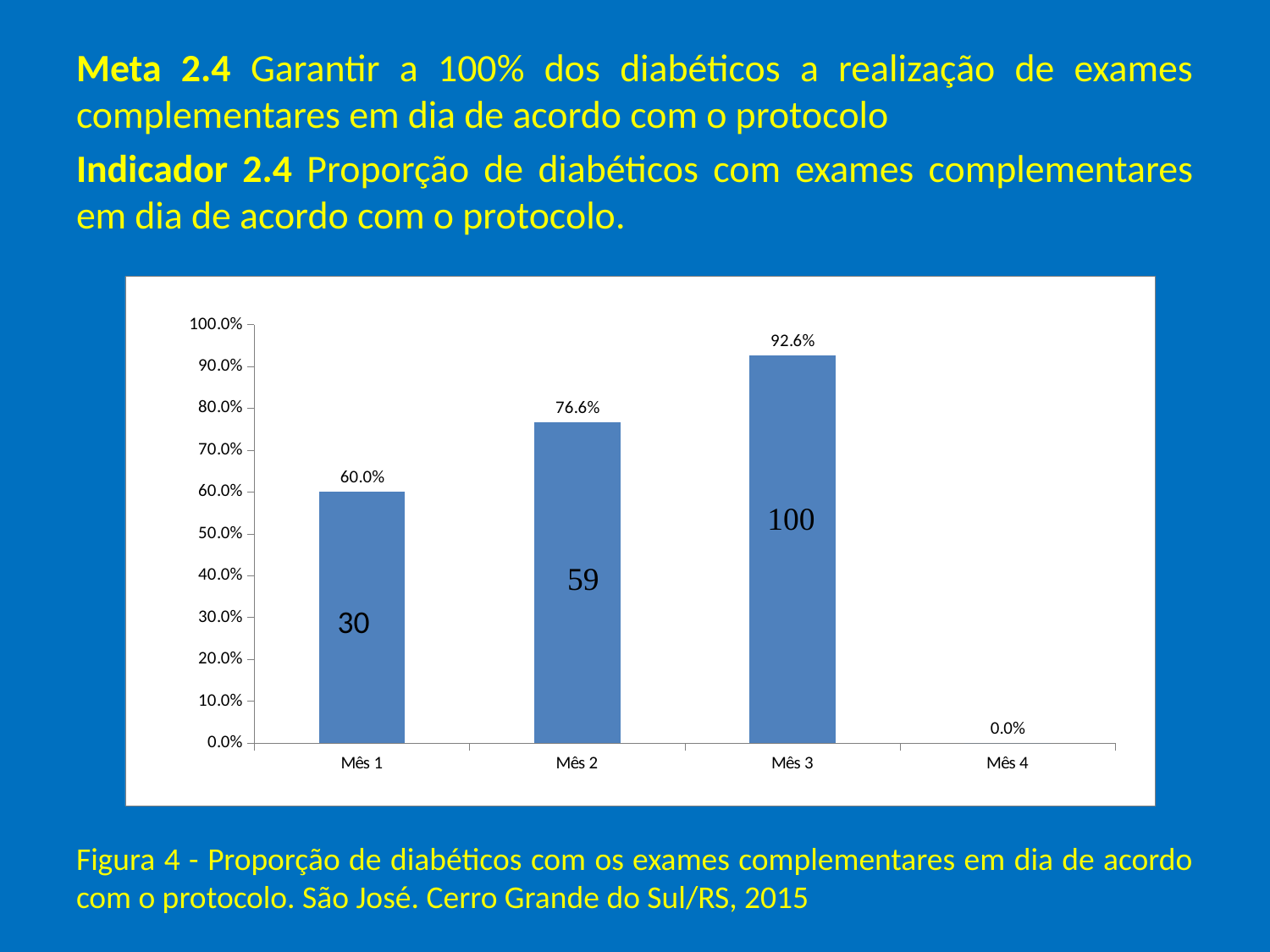
Which month has the highest value? Mês 3 What is the value for Mês 2? 76.6% What is the value for Mês 1? 60.0% What is the difference between the values for Mês 2 and Mês 1? 16.6% What number is printed inside the bar for Mês 2? 59 How many months are shown on the x axis? 4 Which month has the lowest value? Mês 4 What is the value for Mês 3? 92.6% What is the value for Mês 4? 0.0% What is the difference between the values for Mês 3 and Mês 2? 16.0% Which is larger, the value for Mês 1 or the value for Mês 2? Mês 2 What kind of chart is shown on the slide? bar chart